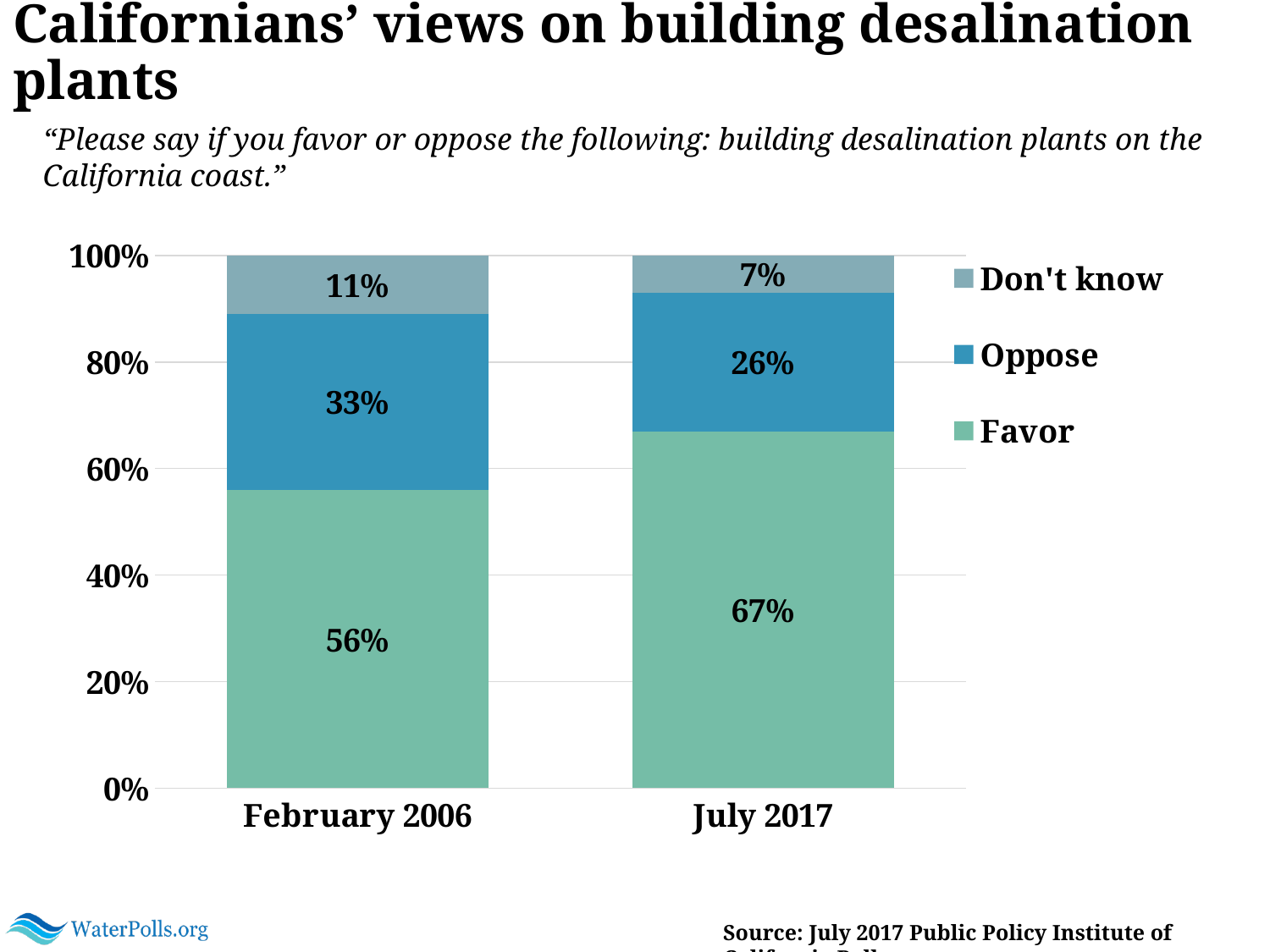
What type of chart is shown on the slide? Stacked bar chart What percentage of Californians favored building desalination plants in February 2006? 56% What is the 'Don't know' value for February 2006? 11% Did the 'Favor' share rise or fall from February 2006 to July 2017? Rise In which survey period was the 'Oppose' share lowest? July 2017 What is the 'Favor' value for July 2017? 67% What percentage of Californians opposed building desalination plants in July 2017? 26% Which is larger: the 'Don't know' share in February 2006 or in July 2017? February 2006 What is the difference between the 'Oppose' values for February 2006 and July 2017? 7 percentage points In which survey period was the 'Favor' share highest? July 2017 How many series does the legend list? 3 By how many percentage points did the 'Favor' share change from February 2006 to July 2017? 11 percentage points